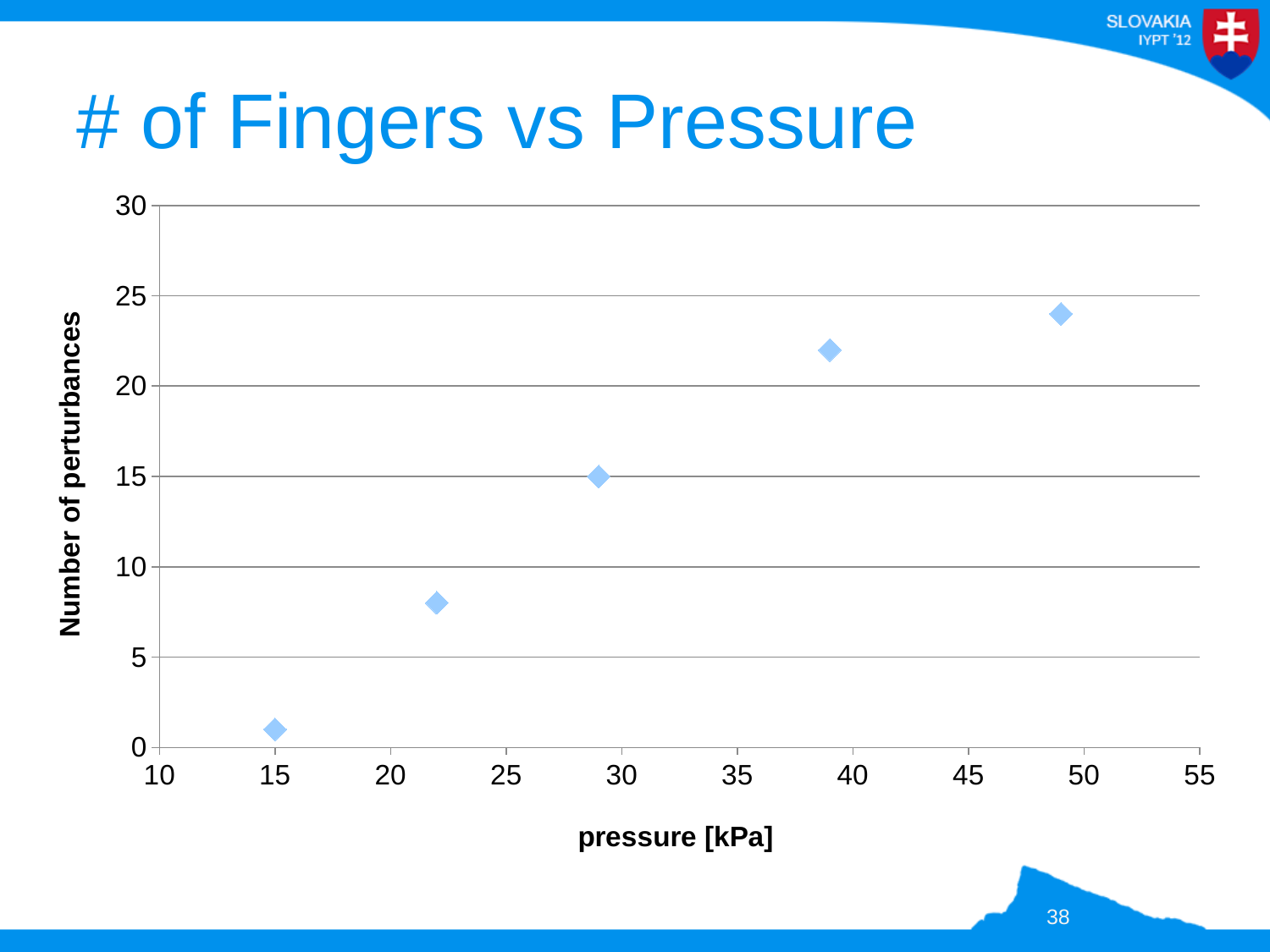
Which has more perturbances: the point near 29 kPa or the point near 22 kPa? the point near 29 kPa Is the number of perturbances at 15 kPa greater or less than 5? less What is the label of the y axis? Number of perturbances What kind of chart is shown on the slide? scatter chart At which pressure is the number of perturbances lowest? 15 kPa Is the number of perturbances at the point near 22 kPa greater or less than 10? less Does the number of perturbances rise or fall as pressure increases along the x axis? rise What is the title of the chart on the slide? # of Fingers vs Pressure Is the number of perturbances at the point near 49 kPa greater or less than 25? less How many data points are plotted on the chart? 5